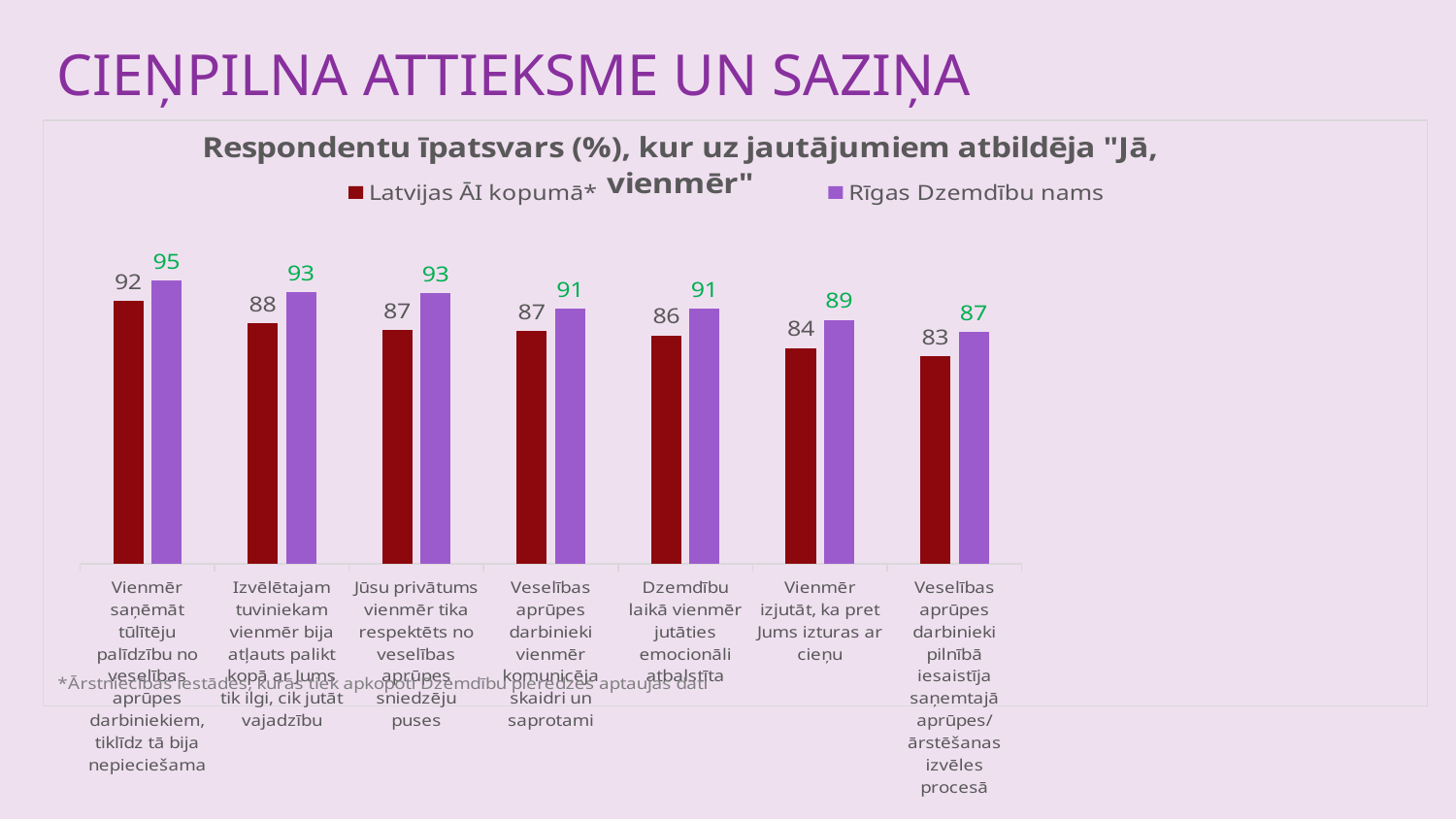
What is the value for Latvijas ĀI kopumā* for the category "Dzemdību laikā vienmēr jutāties emocionāli atbalstīta"? 86 Which colour represents the Rīgas Dzemdību nams series in the chart? Purple Which category has the highest value for Rīgas Dzemdību nams? Vienmēr saņēmāt tūlītēju palīdzību no veselības aprūpes darbiniekiem, tiklīdz tā bija nepieciešama For the category "Vienmēr izjutāt, ka pret Jums izturas ar cieņu", which series has the larger value: Latvijas ĀI kopumā* or Rīgas Dzemdību nams? Rīgas Dzemdību nams Which category has the lowest value for Latvijas ĀI kopumā*? Veselības aprūpes darbinieki pilnībā iesaistīja saņemtajā aprūpes/ārstēšanas izvēles procesā How many categories are shown on the x axis of the chart? 7 Do the Latvijas ĀI kopumā* values rise or fall from left to right across the categories? Fall How many series does the chart legend list? 2 What type of chart is shown on the slide? Bar chart What is the difference between the Rīgas Dzemdību nams and Latvijas ĀI kopumā* values for the category "Izvēlētajam tuviniekam vienmēr bija atļauts palikt kopā ar Jums tik ilgi, cik jutāt vajadzību"? 5 What is the value for Rīgas Dzemdību nams for the category "Jūsu privātums vienmēr tika respektēts no veselības aprūpes sniedzēju puses"? 93 What is the value for Rīgas Dzemdību nams for the category "Vienmēr izjutāt, ka pret Jums izturas ar cieņu"? 89